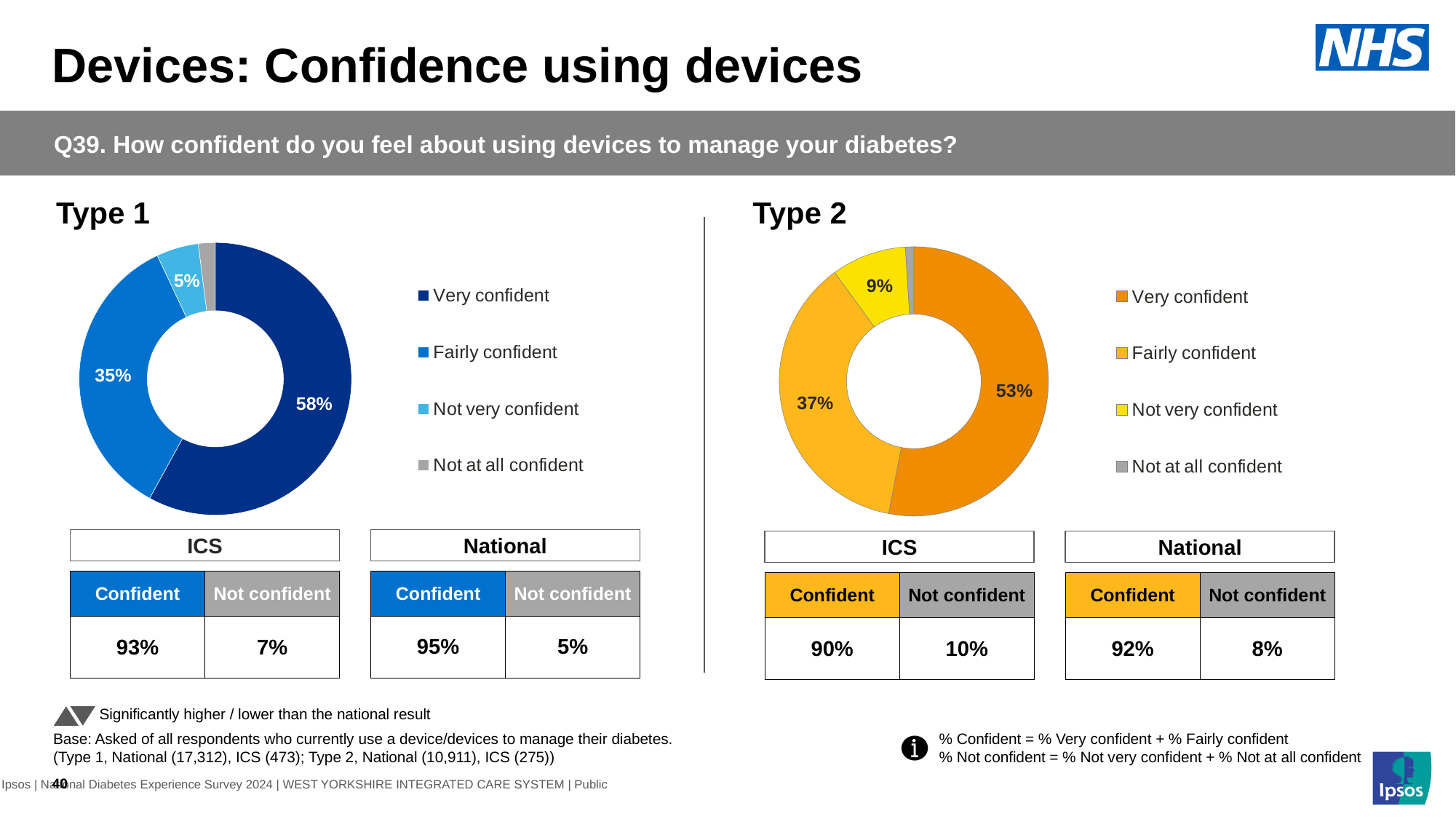
Which chart has the larger share for very confident, Type 1 or Type 2? Type 1 In the Type 2 chart, which category has the smallest share? Not at all confident In the Type 1 chart, what percentage of respondents are not very confident? 5% In the Type 2 chart, what percentage of respondents are not very confident? 9% In the Type 1 chart, which category has the largest share? Very confident In the Type 1 chart, what percentage of respondents are very confident? 58% In the Type 2 chart, what percentage of respondents are fairly confident? 37% In the Type 1 chart, what percentage of respondents are fairly confident? 35% In the Type 2 chart, what percentage of respondents are very confident? 53% What kind of chart is used for Type 1? Donut (pie) chart In the Type 1 chart, what is the difference between the very confident and fairly confident shares? 23% How many categories does the legend of the Type 2 chart list? 4